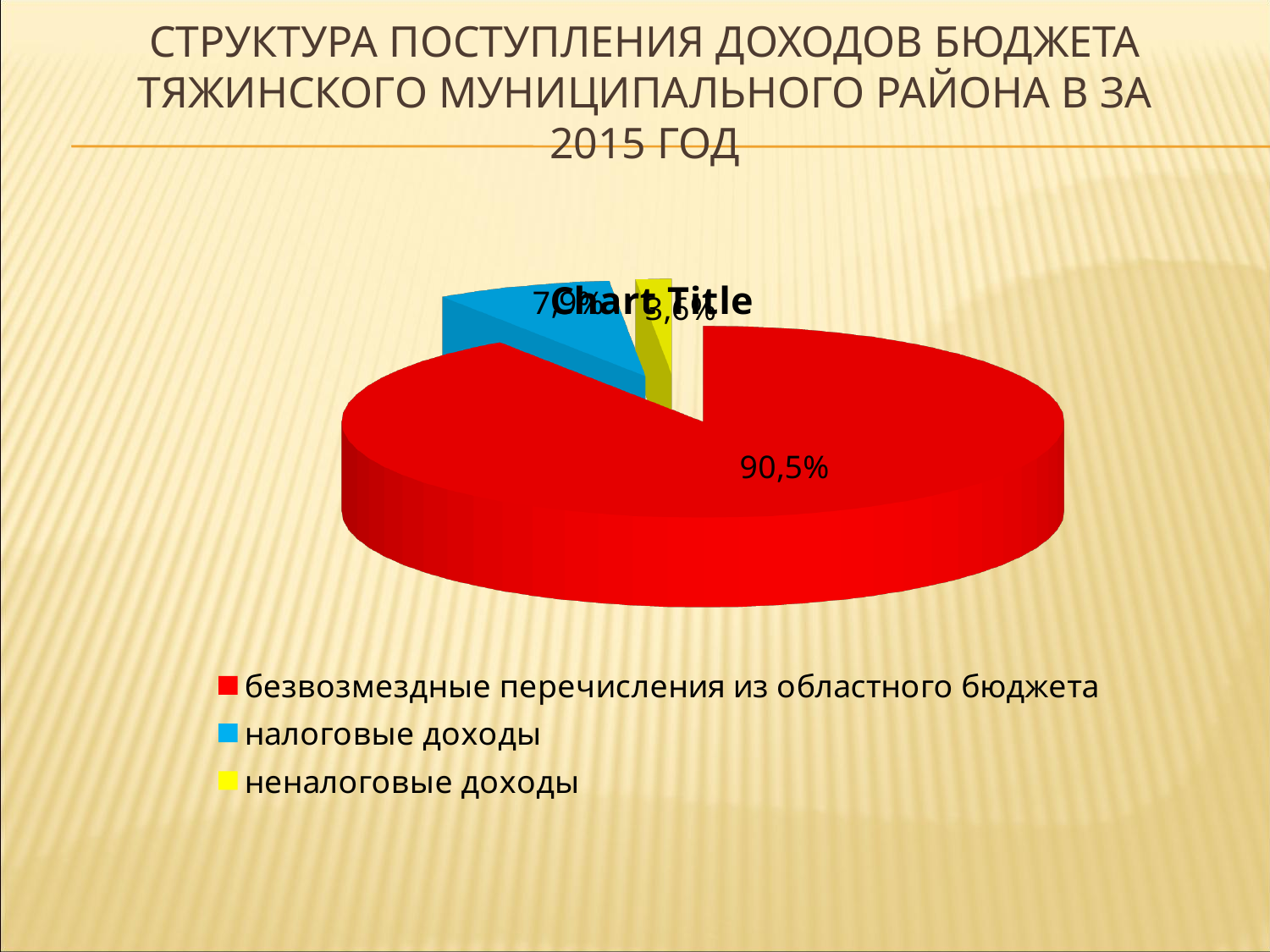
How many slices does the pie chart have? 3 What share of the pie does the slice for безвозмездные перечисления из областного бюджета have? 90,5% Which slice is larger: налоговые доходы or неналоговые доходы? налоговые доходы Which category has the smallest slice of the pie? неналоговые доходы What colour is the slice for налоговые доходы? blue What kind of chart is shown on the slide? pie chart What colour is the slice for безвозмездные перечисления из областного бюджета? red Is the share for безвозмездные перечисления из областного бюджета greater or less than 50%? greater How many entries does the legend list? 3 Which category has the largest slice of the pie? безвозмездные перечисления из областного бюджета